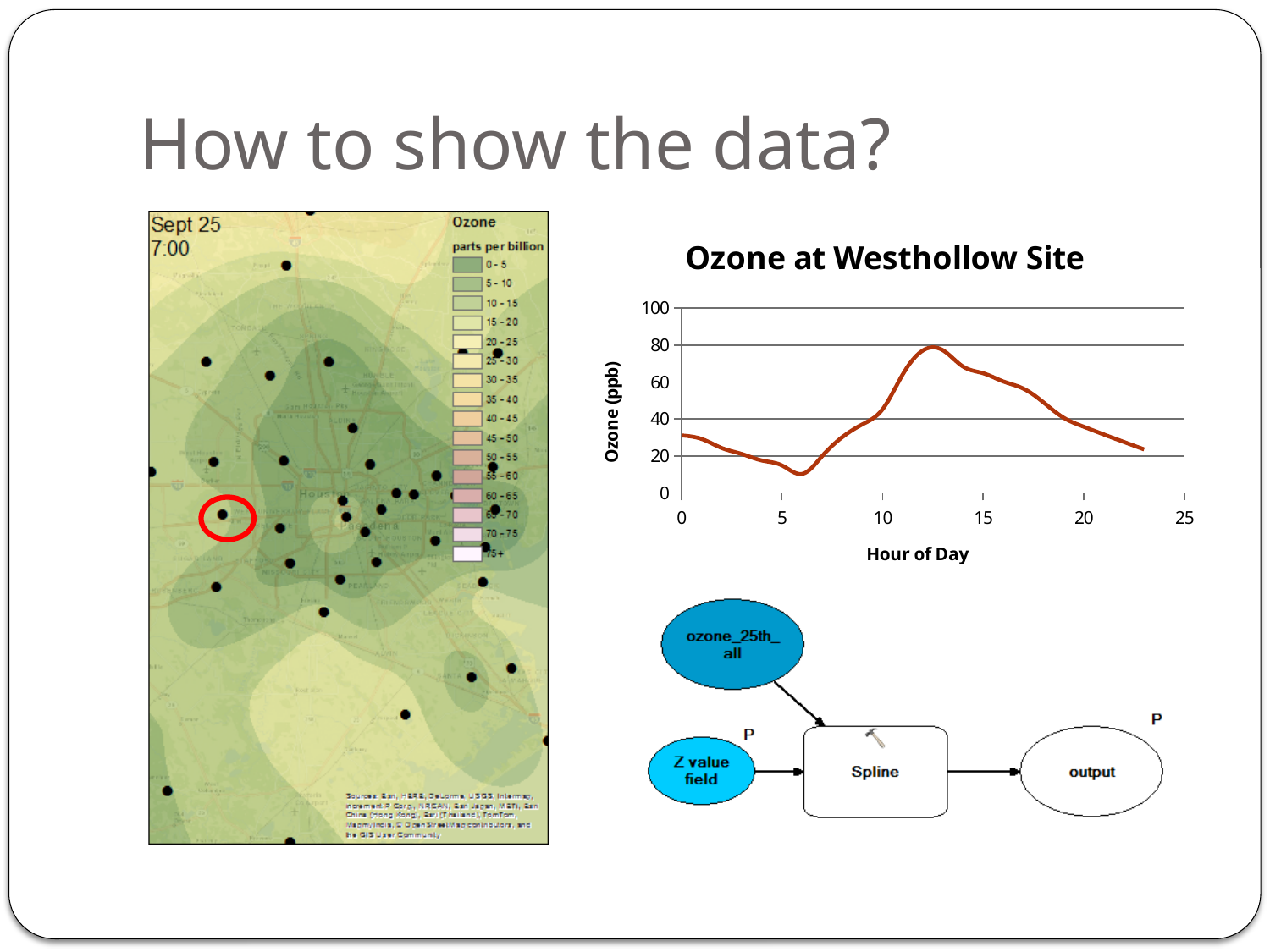
In the "Ozone at Westhollow Site" chart, is the ozone value at hour 12 greater or less than 60? greater In the "Ozone at Westhollow Site" chart, is the ozone value at hour 20 greater or less than 60? less How many lines are plotted in the "Ozone at Westhollow Site" chart? 1 In the "Ozone at Westhollow Site" chart, is the ozone value at hour 0 greater or less than 40? less In the "Ozone at Westhollow Site" chart, does the ozone value rise or fall between hour 0 and hour 6? fall What is the title of the line chart on the right of the slide? Ozone at Westhollow Site What kind of chart is "Ozone at Westhollow Site"? line chart In the "Ozone at Westhollow Site" chart, what is the label of the x axis? Hour of Day In the "Ozone at Westhollow Site" chart, is the ozone value at hour 12 larger or smaller than the value at hour 6? larger In the "Ozone at Westhollow Site" chart, does the ozone value rise or fall between hour 6 and hour 12? rise In the "Ozone at Westhollow Site" chart, does the ozone value rise or fall between hour 15 and hour 23? fall